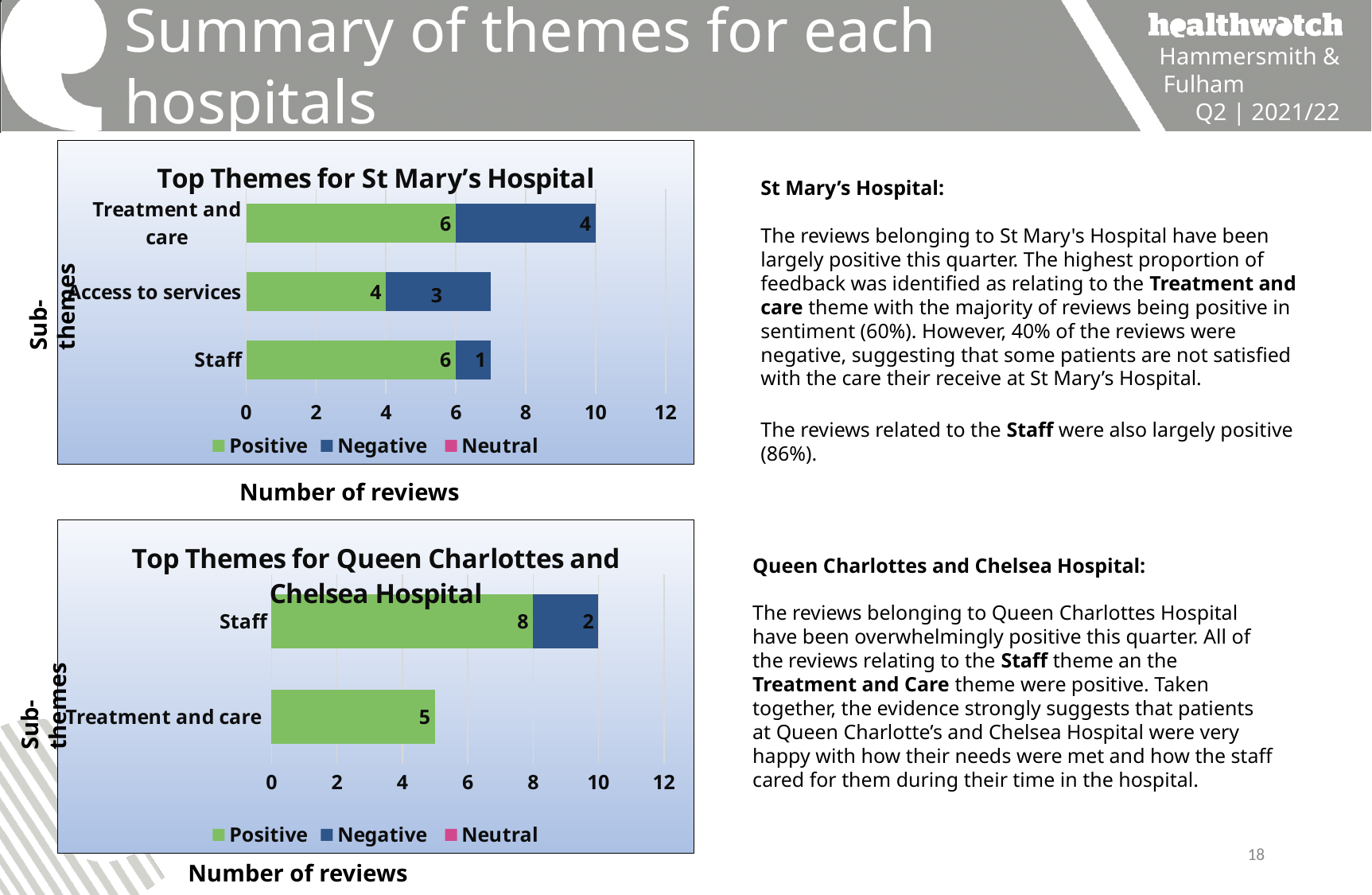
In the 'Top Themes for Queen Charlottes and Chelsea Hospital' chart, how many Positive reviews are shown for Treatment and care? 5 In the 'Top Themes for Queen Charlottes and Chelsea Hospital' chart, how many Positive reviews are shown for Staff? 8 What type of chart is the 'Top Themes for St Mary's Hospital' chart? Stacked bar chart In the 'Top Themes for St Mary's Hospital' chart, how many Negative reviews are shown for Access to services? 3 In the 'Top Themes for St Mary's Hospital' chart, what is the difference between Positive and Negative reviews for Staff? 5 In the 'Top Themes for Queen Charlottes and Chelsea Hospital' chart, what is the total number of reviews for Staff? 10 In the 'Top Themes for St Mary's Hospital' chart, how many Positive reviews are shown for Treatment and care? 6 How many series does the legend list in the 'Top Themes for Queen Charlottes and Chelsea Hospital' chart? 3 In the 'Top Themes for St Mary's Hospital' chart, what is the total number of reviews for Treatment and care? 10 In the 'Top Themes for St Mary's Hospital' chart, which sub-theme has the lowest number of Negative reviews? Staff In the 'Top Themes for Queen Charlottes and Chelsea Hospital' chart, which sub-theme has more Positive reviews, Staff or Treatment and care? Staff How many sub-themes are shown in the 'Top Themes for St Mary's Hospital' chart? 3